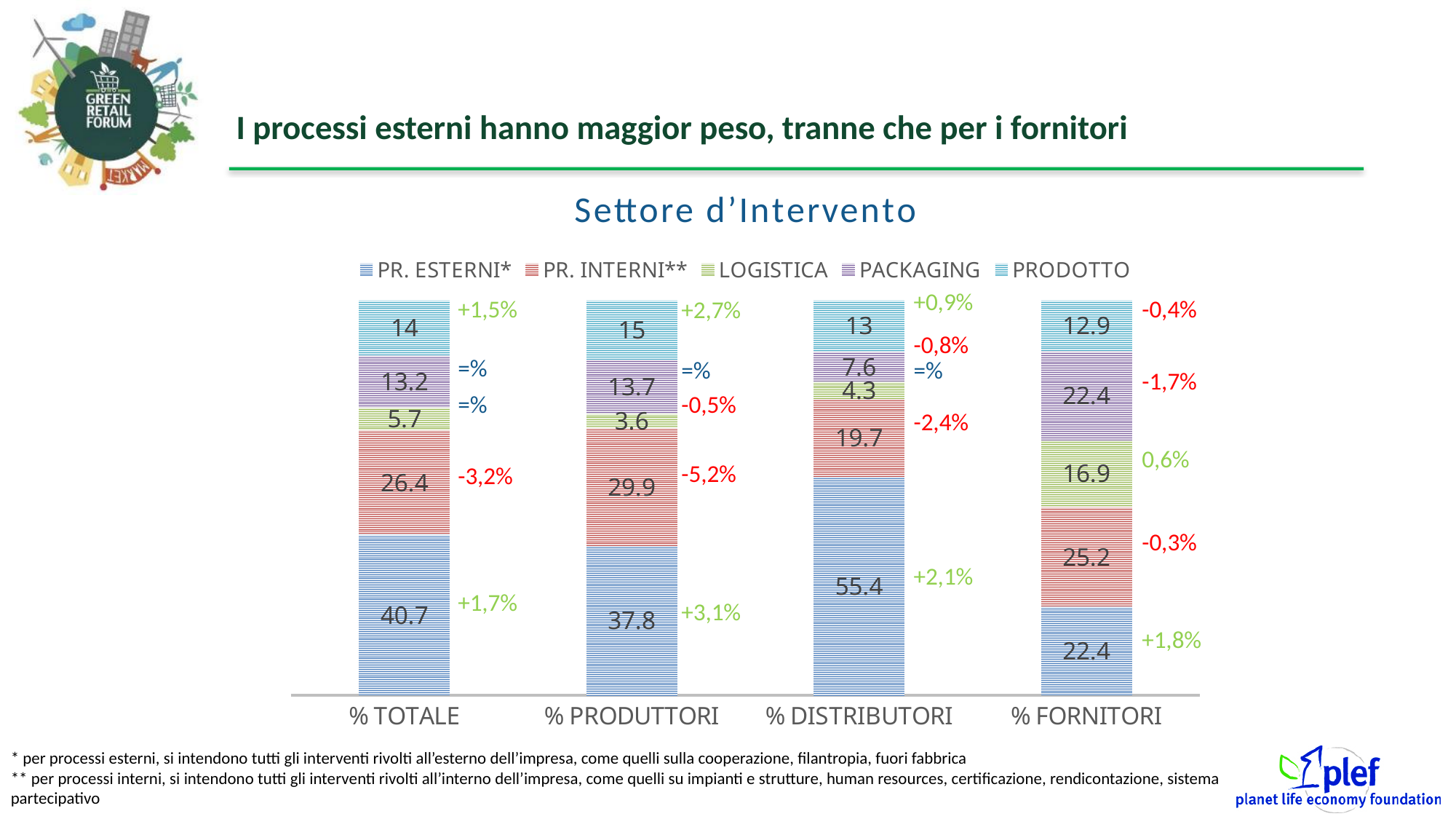
What is the title of the chart? Settore d'Intervento What is the value of PR. ESTERNI* for % DISTRIBUTORI? 55.4 What kind of chart is shown on the slide? Stacked bar chart Which category has the highest PR. ESTERNI* value? % DISTRIBUTORI How many series does the legend list? 5 What is the difference between the PR. ESTERNI* values for % DISTRIBUTORI and % FORNITORI? 33 Which category has the lowest LOGISTICA value? % PRODUTTORI What is the value of PACKAGING for % TOTALE? 13.2 What is the value of PR. INTERNI** for % PRODUTTORI? 29.9 What is the value of LOGISTICA for % FORNITORI? 16.9 How many categories are shown on the x axis? 4 Which is larger for % FORNITORI: PR. ESTERNI* or PR. INTERNI**? PR. INTERNI**